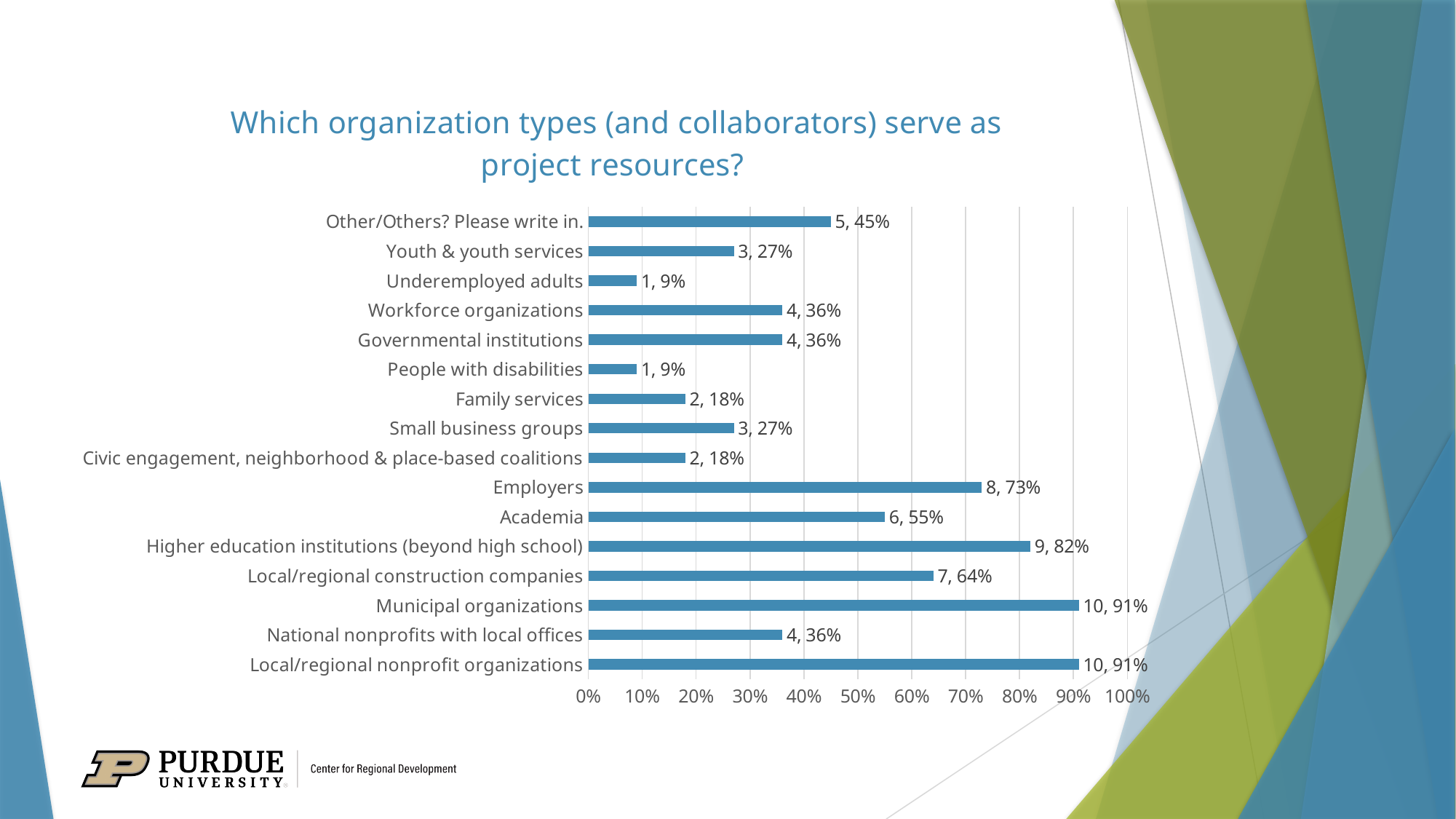
Which two categories share the highest value of 91%? Municipal organizations and Local/regional nonprofit organizations What is the difference in percentage points between Employers and Academia? 18 What percentage is shown for Family services? 18% Which two categories share the lowest value of 9%? Underemployed adults and People with disabilities Which has a larger value, Youth & youth services or Workforce organizations? Workforce organizations What count is shown for Academia? 6 What kind of chart is shown on the slide? Bar chart What percentage is shown for Higher education institutions (beyond high school)? 82% How many categories are shown in the chart? 16 Is the value for Other/Others? Please write in. greater or less than 40%? greater What is the data label for Local/regional construction companies? 7, 64% What is the data label for Employers? 8, 73%